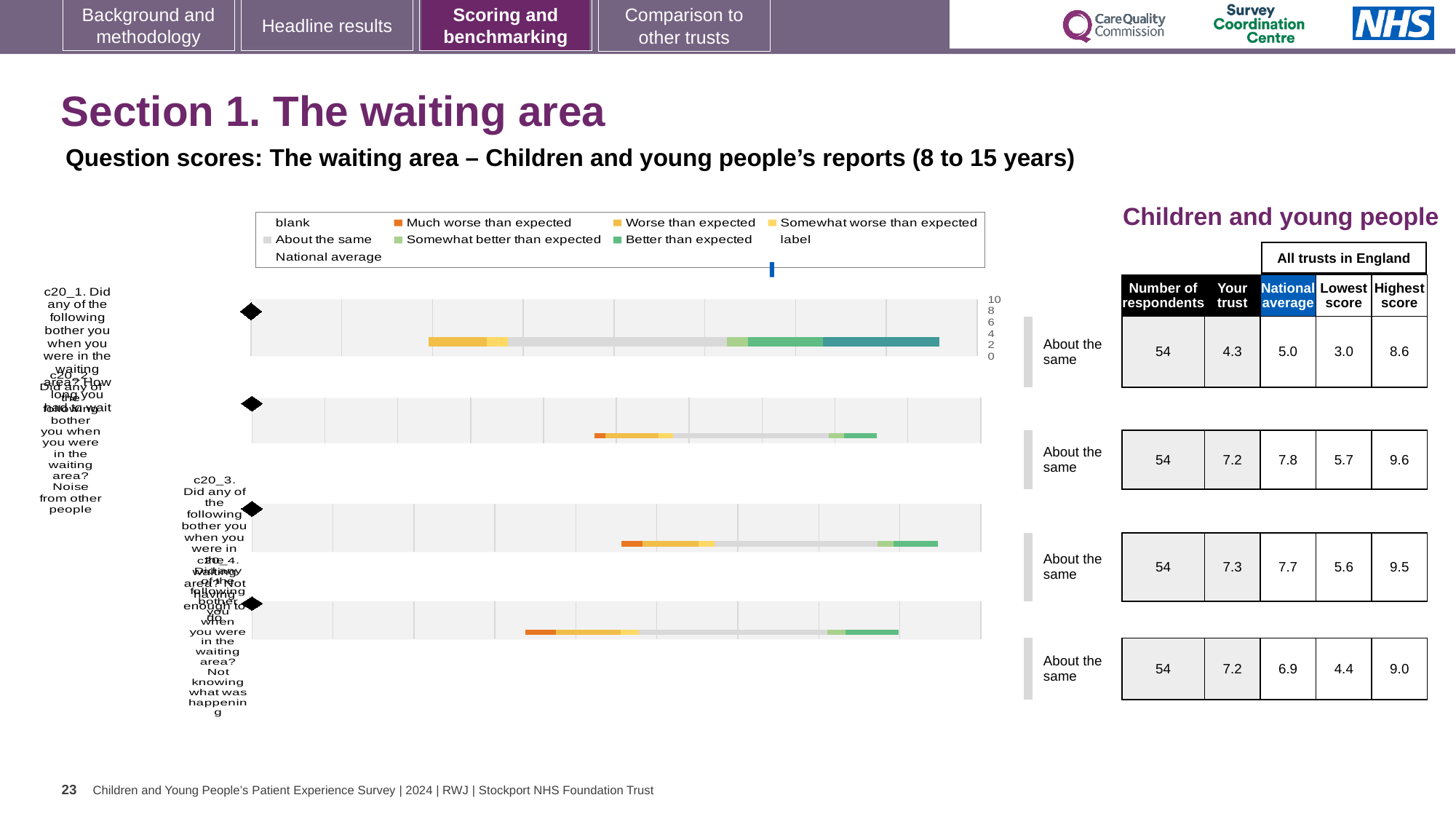
Which row has the lowest 'Your trust' score in the table? c20_1 In the table, what is the highest score for the third row (c20_3)? 9.5 In the chart legend, which colour represents 'Much worse than expected'? orange What is the maximum value shown on the chart's score axis? 10 How many respondents are listed for each question in the table? 54 In the table, what is the lowest score for the fourth row (c20_4)? 4.4 How many question rows (bars) are plotted in the chart area? 4 Which row has the highest 'Highest score' value in the table? c20_2 In the table, what is the national average for the second row (c20_2)? 7.8 For the first row (c20_1), what is the difference between the national average and the 'Your trust' score? 0.7 In the table, what is the 'Your trust' score for the first row (c20_1)? 4.3 What kind of chart is used to show the question scores on this slide? bar chart